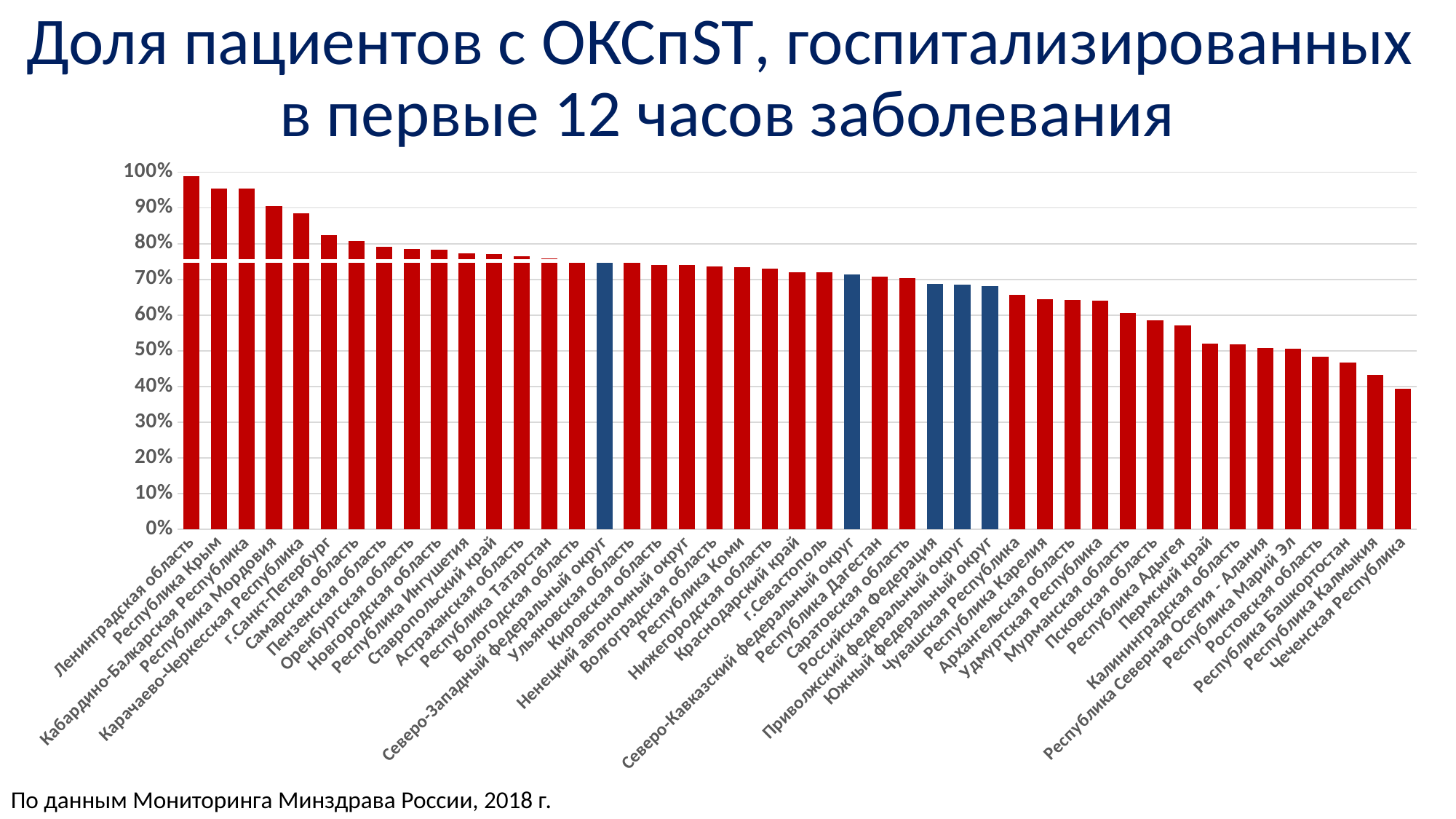
Do the values rise or fall from left to right along the x axis? Fall Which region has the lowest share of patients hospitalized in the first 12 hours? Чеченская Республика Is the value for Чеченская Республика greater or less than 50%? less Which region has the highest share of patients hospitalized in the first 12 hours? Ленинградская область How many bars are shown in blue rather than red? 5 What is the source cited at the bottom of the slide? По данным Мониторинга Минздрава России, 2018 г. Is the value for Российская Федерация greater or less than 70%? less Which is larger, the value for Карачаево-Черкесская Республика or the value for Ростовская область? Карачаево-Черкесская Республика Is the value for Республика Калмыкия greater or less than 50%? less What kind of chart is shown on the slide? Bar chart